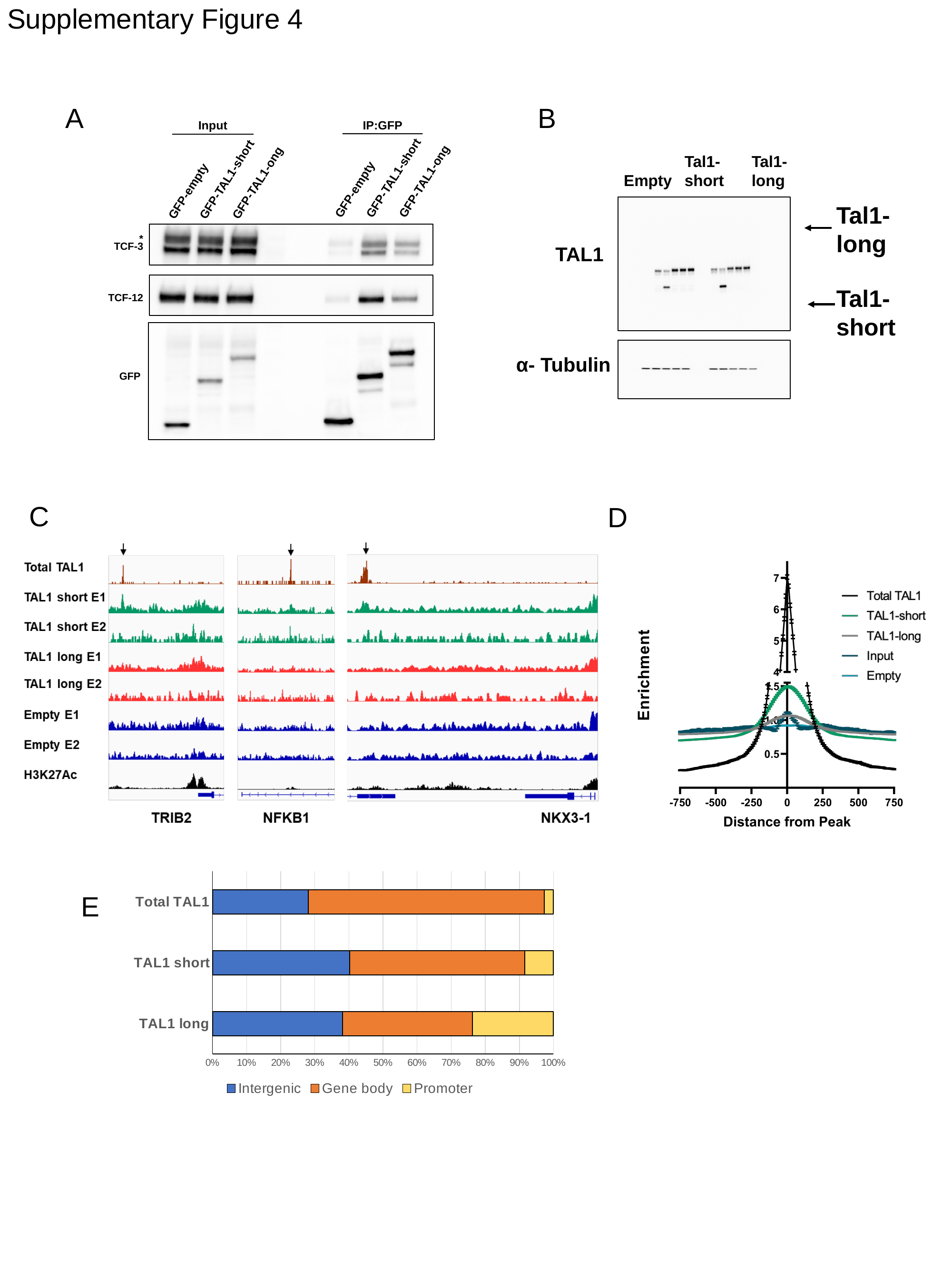
In panel D, which series reaches the highest enrichment at distance 0 from the peak? Total TAL1 In panel D, how many series does the legend list? 5 In panel E, which category has the largest Gene body segment? Total TAL1 In panel E, which category has the largest Promoter segment? TAL1 long In panel E, how many categories (bars) are shown? 3 In panel E, is the Intergenic share for Total TAL1 greater or less than 40%? less What kind of chart is panel E? Stacked bar chart In panel E, which category has the smallest Intergenic segment? Total TAL1 In panel E, is the Promoter share for TAL1 long greater or less than 10%? greater What kind of chart is panel D? Line chart In panel E, how many series does the legend list? 3 In panel E, is the Promoter share for Total TAL1 greater or less than 10%? less